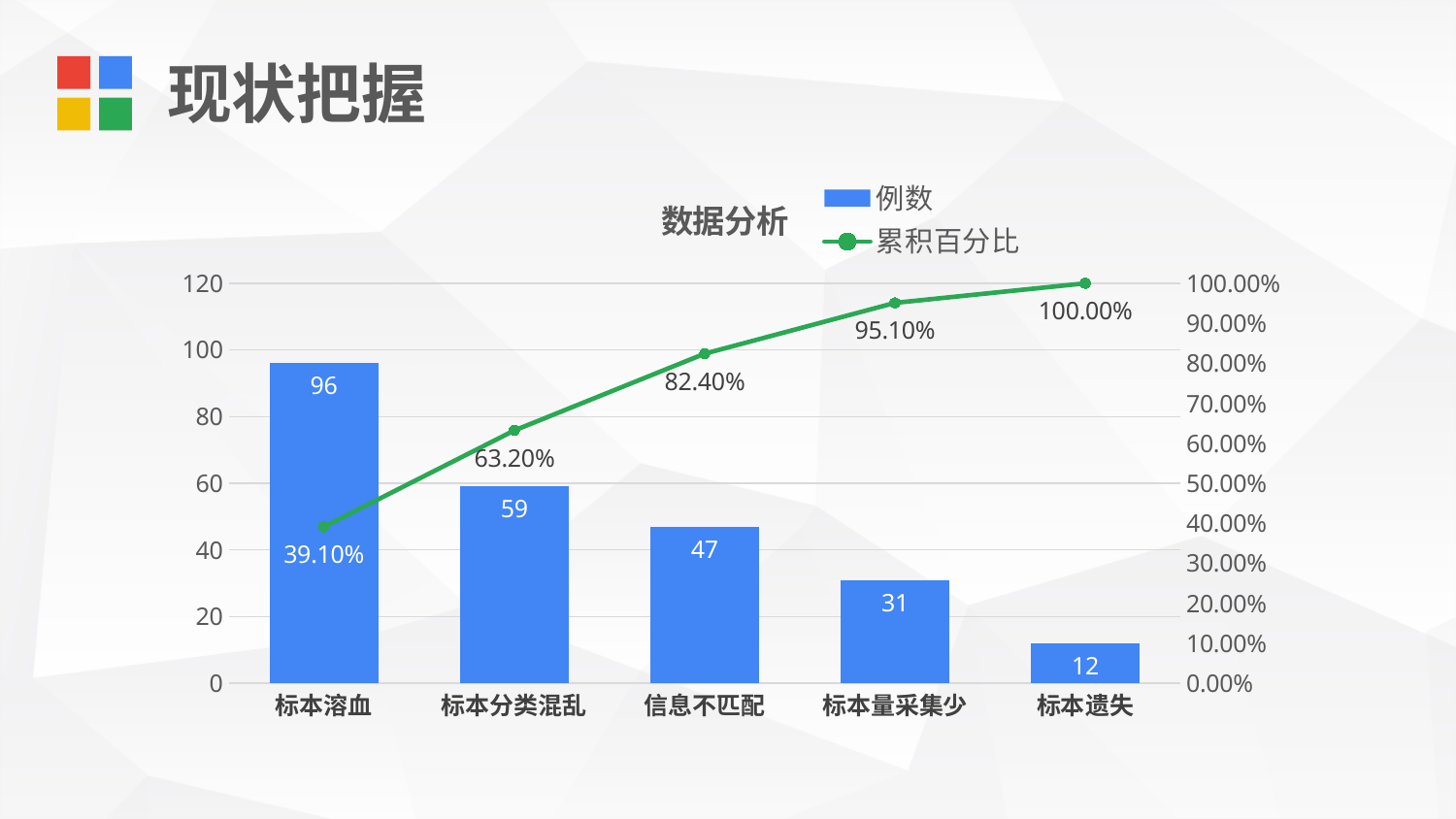
What is the title of the chart? 数据分析 Does the 累积百分比 line rise or fall from left to right? Rise How many categories are shown on the x axis? 5 What is the 例数 value for 标本溶血? 96 Which category has the lowest 例数? 标本遗失 What kind of chart is this? Combined bar and line chart How many series does the legend list? 2 Which has a larger 例数, 信息不匹配 or 标本量采集少? 信息不匹配 What is the 例数 value for 标本量采集少? 31 What is the 累积百分比 value for 信息不匹配? 82.40% What is the difference in 例数 between 标本分类混乱 and 信息不匹配? 12 Which category has the highest 例数? 标本溶血